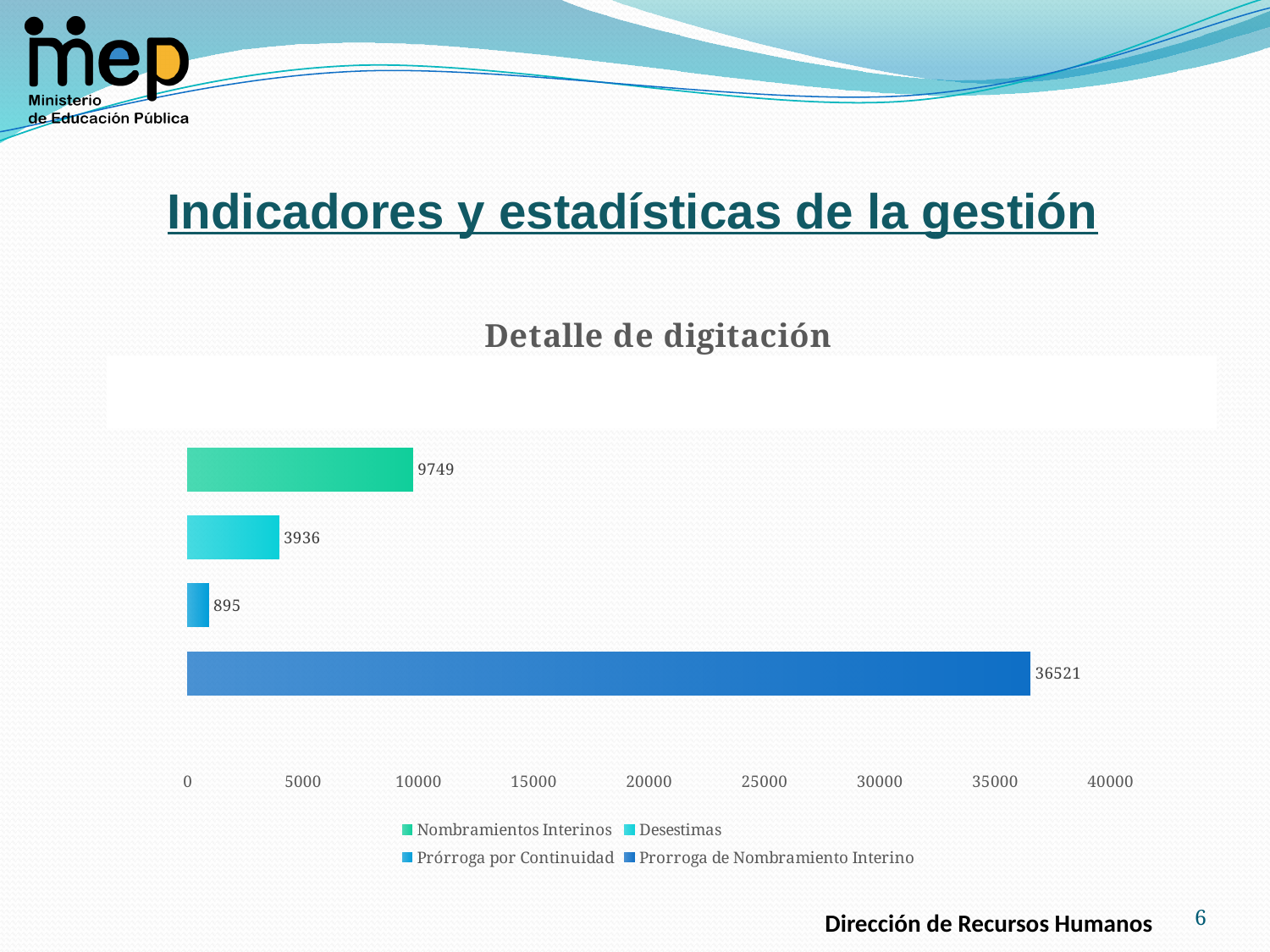
What is the value for Desestimas? 3936 Which series has the lowest value? Prórroga por Continuidad What is the difference between Prorroga de Nombramiento Interino and Nombramientos Interinos? 26772 What is the value for Prórroga por Continuidad? 895 Which series has the highest value? Prorroga de Nombramiento Interino What is the value for Prorroga de Nombramiento Interino? 36521 What kind of chart is shown on the slide? bar chart What is the value for Nombramientos Interinos? 9749 Which is larger, Desestimas or Nombramientos Interinos? Nombramientos Interinos What is the title of the chart? Detalle de digitación Is the value for Prorroga de Nombramiento Interino greater or less than 35000? greater How many series does the legend list? 4